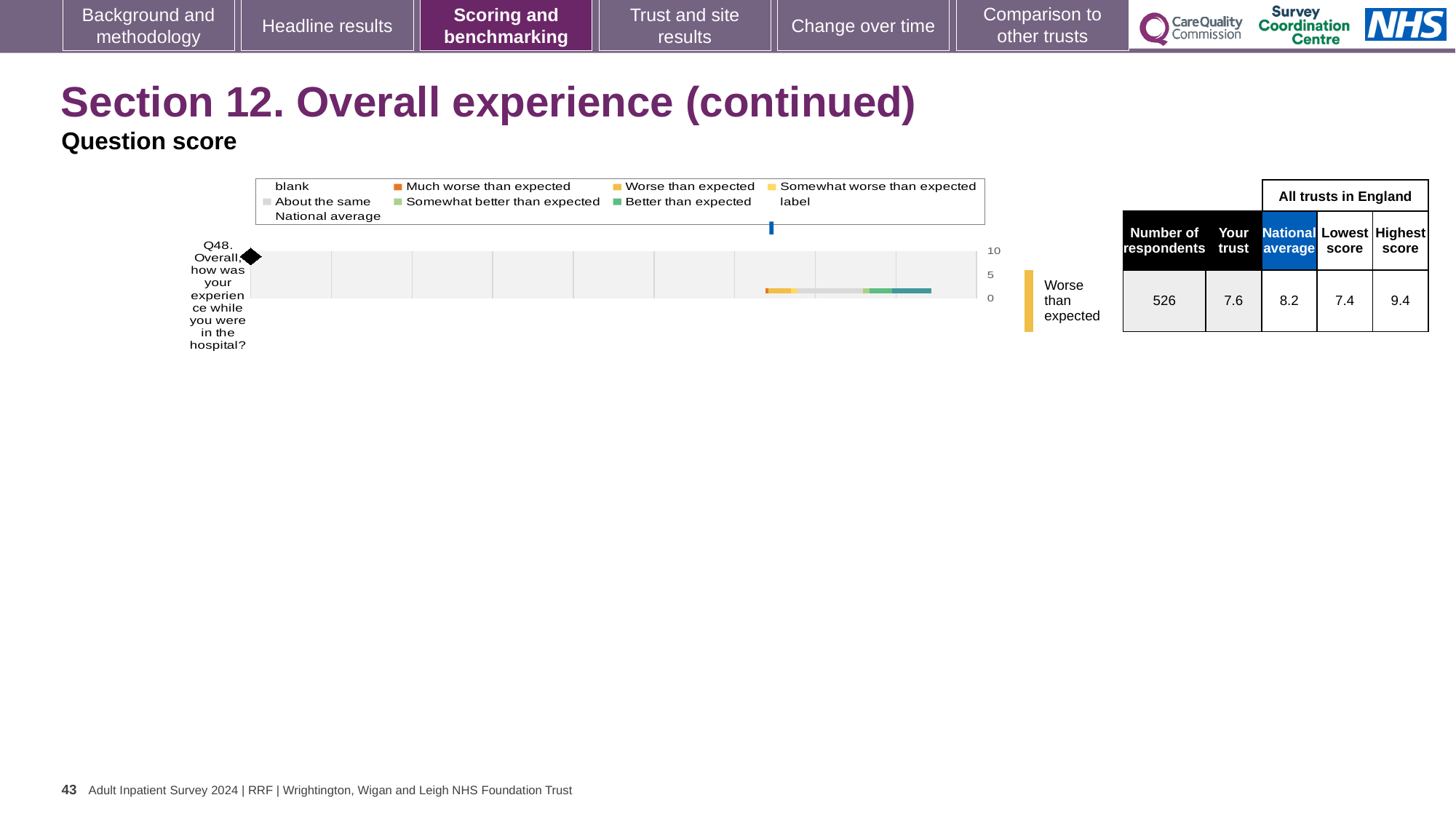
What is the 'Your trust' score for Q48 (Overall, how was your experience while you were in the hospital?)? 7.6 How many survey questions are plotted on the chart? 1 What is the difference between the highest and lowest scores among all trusts in England for Q48? 2.0 Which benchmarking category is the trust's Q48 result labelled with? Worse than expected What is the maximum value shown on the chart's score axis? 10 What is the highest score among all trusts in England for Q48? 9.4 Which is larger for Q48: the 'Your trust' score or the national average? National average What is the national average score for Q48? 8.2 How many respondents answered Q48? 526 What is the difference between the national average and the 'Your trust' score for Q48? 0.6 What is the lowest score among all trusts in England for Q48? 7.4 What kind of chart is used to show the Q48 question score? bar chart